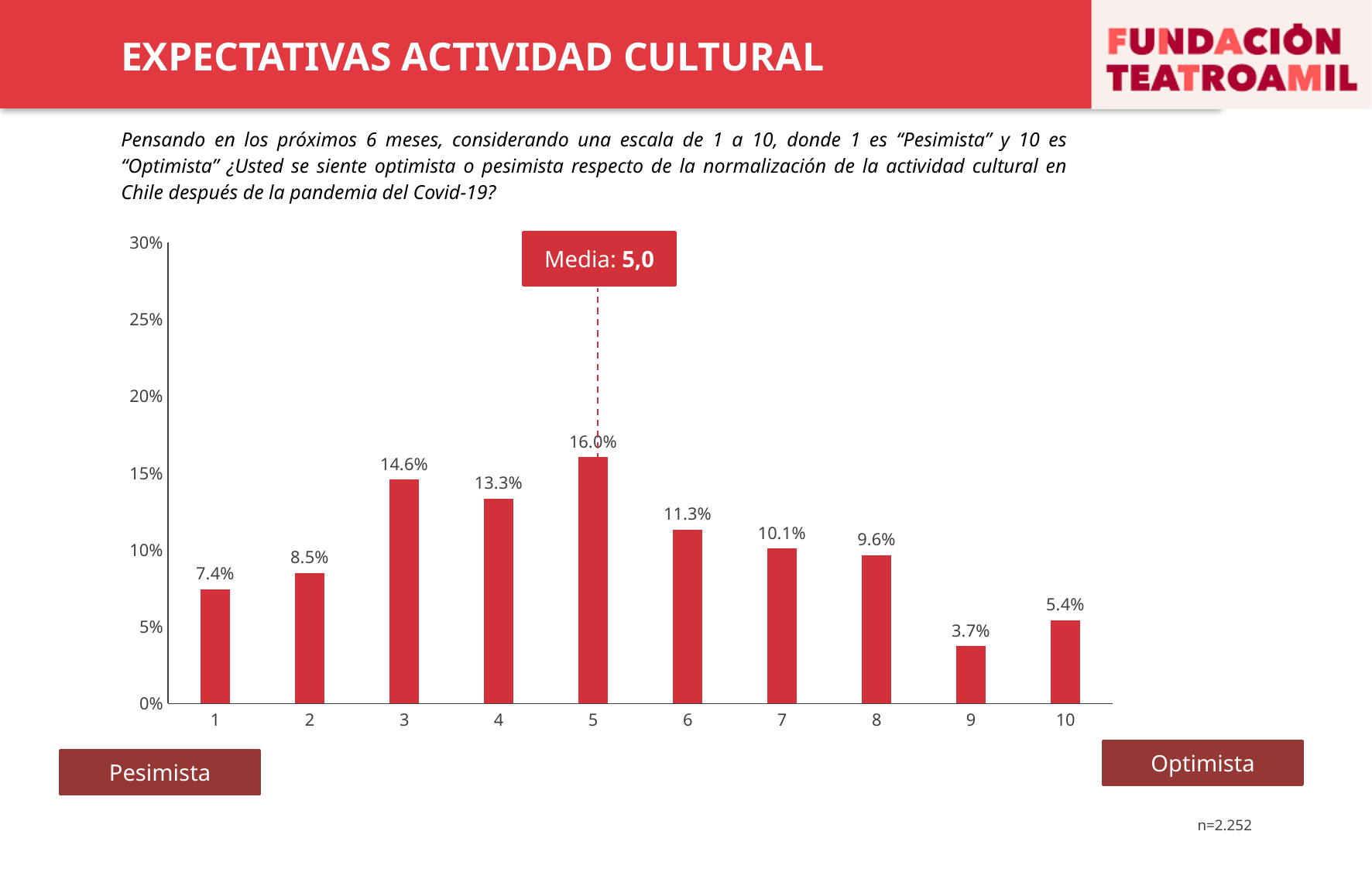
What is the value for scale point 1? 7.4% How many scale points are shown on the x axis? 10 What is the value for scale point 9? 3.7% What kind of chart is shown on the slide? Bar chart Is the value for scale point 6 greater or less than 10%? greater What mean (Media) value is shown on the chart? 5,0 What percentage of respondents chose 5 on the scale? 16.0% Which scale point has the highest percentage? 5 What is the difference between the values for 3 and 4? 1.3% Which scale point has the lowest percentage? 9 Which has a larger value, scale point 2 or scale point 10? 2 Do the values rise or fall from scale point 5 to scale point 9? Fall